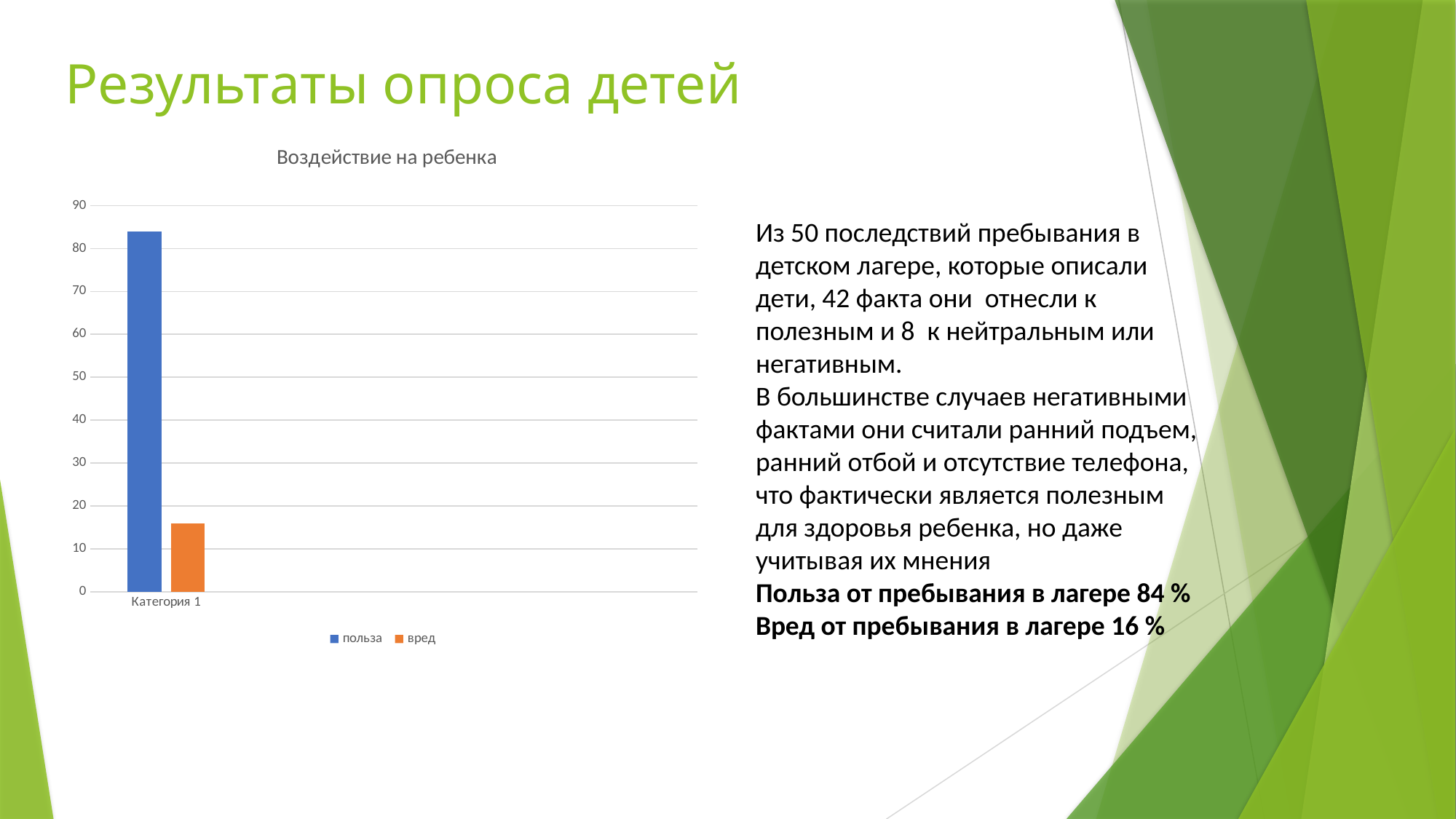
How many series does the legend of the chart list? 2 What is the title of the chart? Воздействие на ребенка Is the value for вред greater or less than 10? greater Which is larger in the chart, the bar for польза or the bar for вред? польза What kind of chart is shown on the slide? bar chart How many categories are shown on the x axis of the chart? 1 What colour is the bar for the series польза? blue Is the value for польза greater or less than 80? greater Is the value for вред greater or less than 20? less Which series has the lowest bar in the chart? вред Which series has the highest bar in the chart? польза